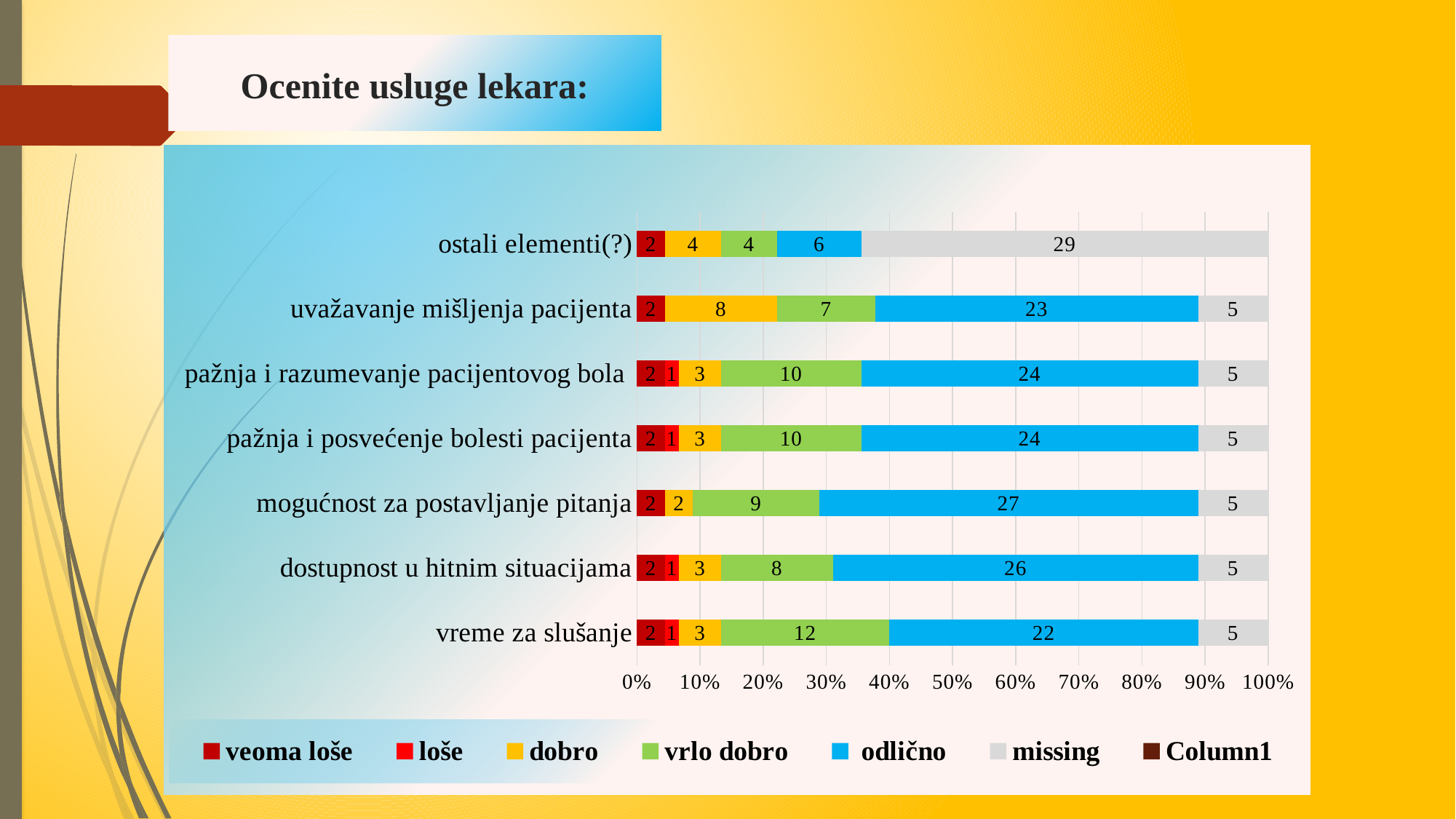
What is the title of the slide? Ocenite usluge lekara: Which is larger: the 'dobro' value for 'uvažavanje mišljenja pacijenta' or the 'dobro' value for 'ostali elementi(?)'? uvažavanje mišljenja pacijenta What is the value of 'odlično' for 'mogućnost za postavljanje pitanja'? 27 How many categories are shown on the chart? 7 What is the 'missing' value for 'ostali elementi(?)'? 29 What is the difference between the 'odlično' values for 'dostupnost u hitnim situacijama' and 'vreme za slušanje'? 4 Which category has the highest 'odlično' value? mogućnost za postavljanje pitanja What is the 'vrlo dobro' value for 'vreme za slušanje'? 12 What kind of chart is shown on the slide? stacked bar chart How many series does the legend list? 7 What is the total of all segments in the bar for 'vreme za slušanje'? 45 Which category has the lowest 'odlično' value? ostali elementi(?)